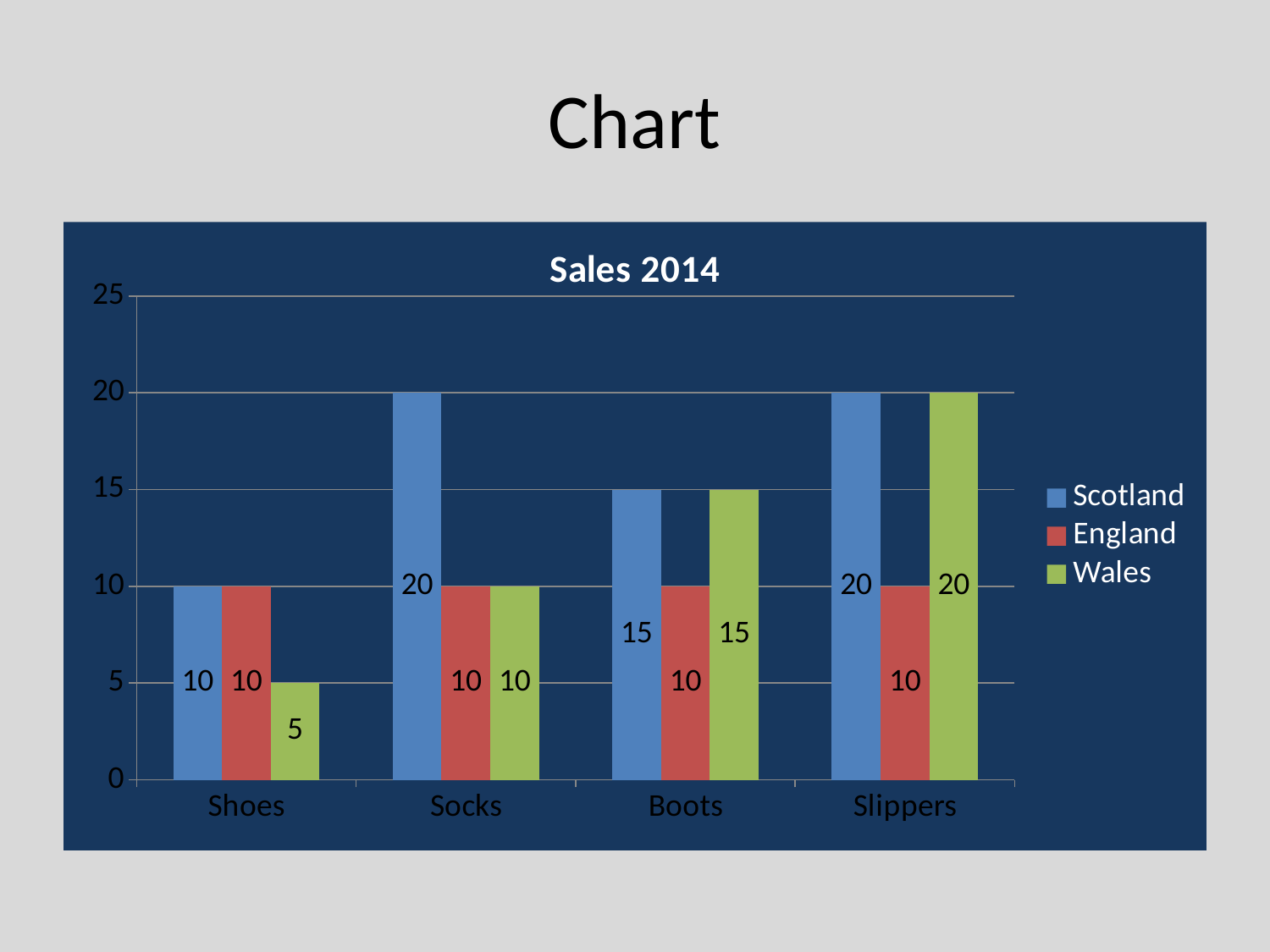
Which category has the lowest value for Wales? Shoes What is the difference between the Wales value for Slippers and the Wales value for Shoes? 15 How many series does the legend list? 3 What is the value for Scotland in the Socks category? 20 How many categories are shown on the x axis? 4 What is the value for Wales in the Shoes category? 5 What is the title of the chart? Sales 2014 What kind of chart is shown on the slide? Bar chart Which colour represents Wales in the chart? Green What is the value for England in the Boots category? 10 Which category has the highest value for Scotland? Socks and Slippers (both 20) Which is larger: the Scotland value for Boots or the Scotland value for Slippers? Slippers